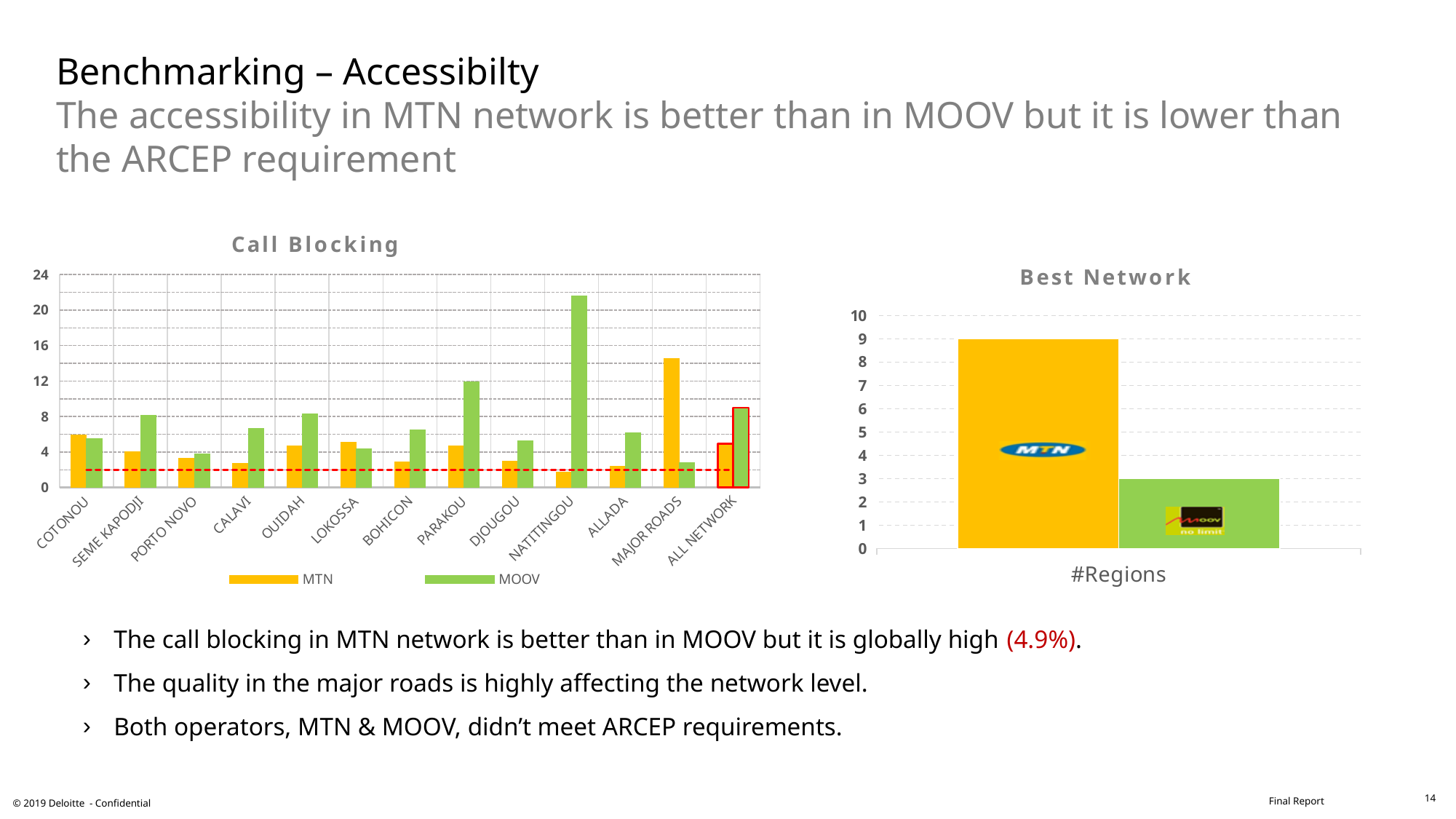
On the Call Blocking chart, in which category is the MTN bar highest? MAJOR ROADS On the Best Network chart, what value does the MOOV bar reach? 3 How many series does the legend of the Call Blocking chart list? 2 On the Call Blocking chart, in which category is the MOOV bar highest? NATITINGOU On the Call Blocking chart, which series has the larger value for PARAKOU? MOOV What kind of chart is the Call Blocking chart? bar chart How many categories are shown on the x axis of the Call Blocking chart? 13 On the Call Blocking chart, is the MOOV value for NATITINGOU greater or less than 20? greater On the Best Network chart, what is the difference between the MTN and MOOV bars? 6 On the Best Network chart, what value does the MTN bar reach? 9 On the Call Blocking chart, is the MTN value for MAJOR ROADS greater or less than 12? greater On the Best Network chart, which operator has the taller bar? MTN